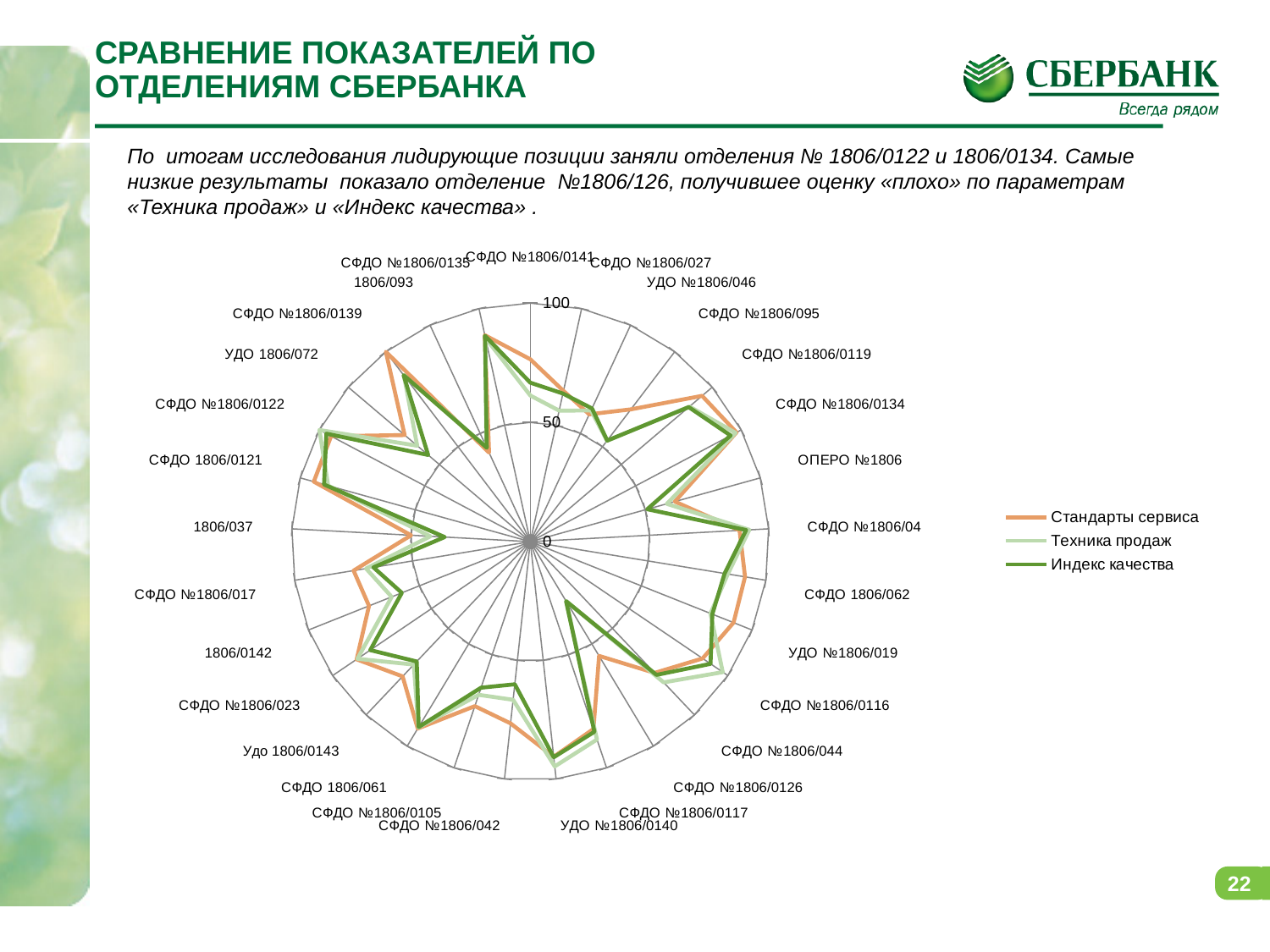
Is the Индекс качества value for СФДО №1806/0122 greater or less than 50? greater Is the Стандарты сервиса value for СФДО №1806/0134 greater or less than 50? greater Is the Стандарты сервиса value for СФДО №1806/0119 greater or less than 50? greater How many branches (categories) are plotted around the radar chart? 29 What kind of chart is shown on the slide? radar chart Which series are listed in the legend? Стандарты сервиса, Техника продаж, Индекс качества What is the maximum value shown on the chart's axis? 100 Which series is drawn in orange? Стандарты сервиса How many series does the legend list? 3